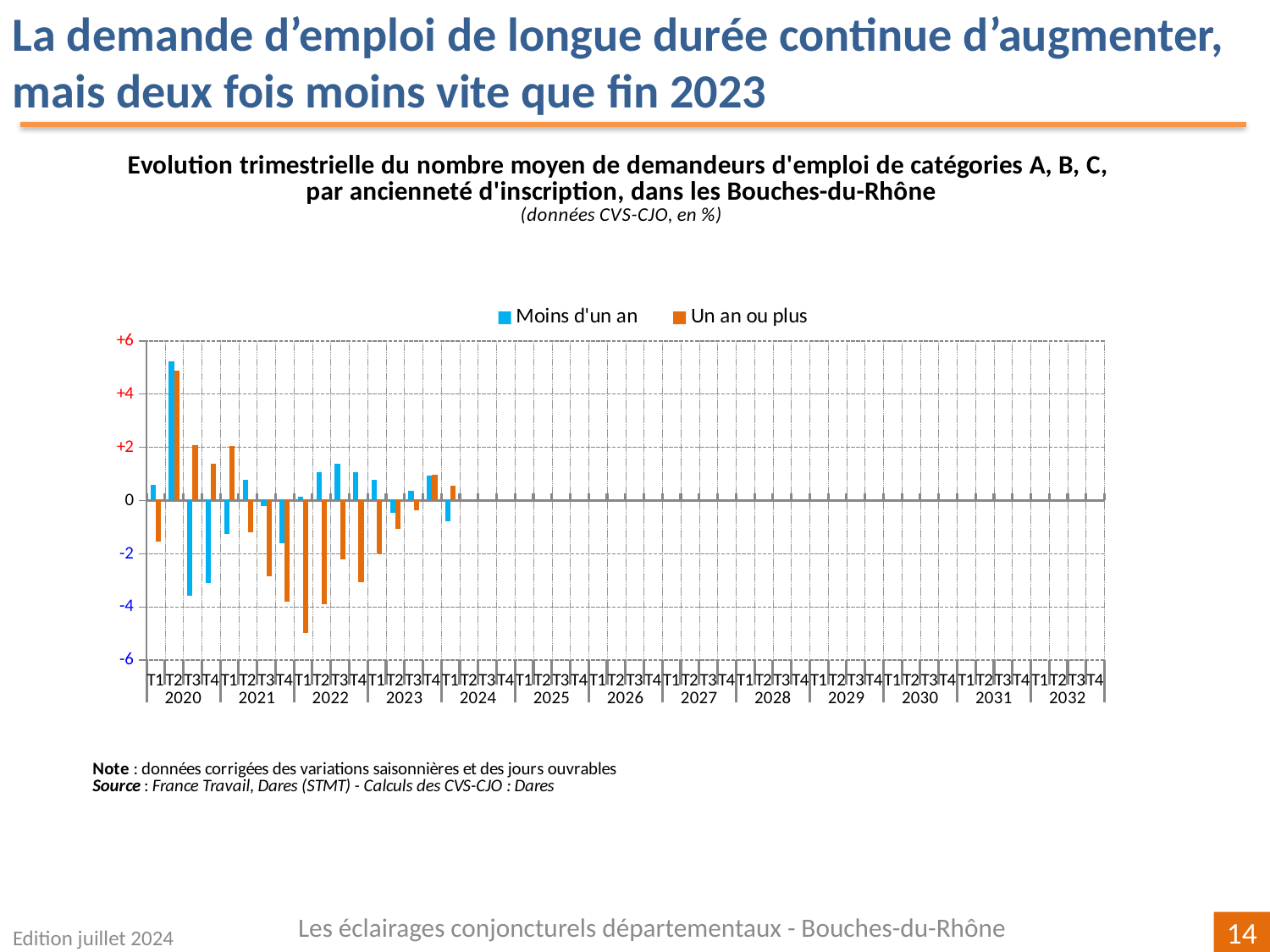
Is the value for 'Un an ou plus' in T1 2022 greater or less than -4? less Is the value for 'Un an ou plus' in T1 2024 greater or less than 0? greater In which quarter does the series 'Un an ou plus' reach its lowest value? T1 2022 Is the value for 'Moins d'un an' in T2 2020 greater or less than +4? greater Which colour represents the series 'Un an ou plus'? Orange In which quarter does the series 'Moins d'un an' reach its highest value? T2 2020 In T1 2024, which series has the higher value, 'Moins d'un an' or 'Un an ou plus'? Un an ou plus In T1 2022, which series has the lower value, 'Moins d'un an' or 'Un an ou plus'? Un an ou plus What are the two series named in the legend? Moins d'un an; Un an ou plus What kind of chart is shown on the slide? Bar chart How many series does the legend list? 2